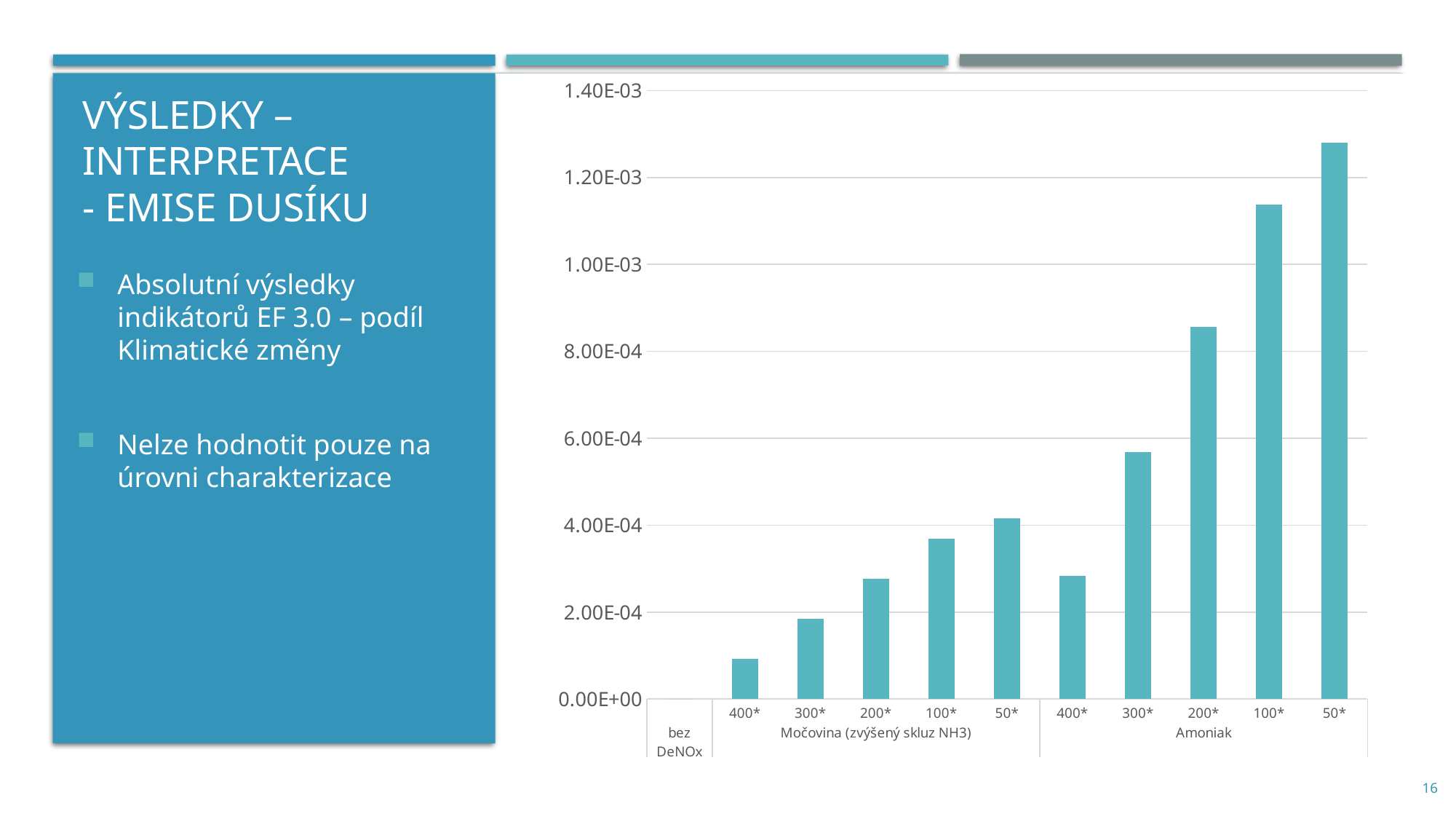
Is the value for Močovina 400* greater or less than 2.00E-04? less Which bar is the highest in the chart? Amoniak 50* Is the value for Močovina 50* greater or less than 4.00E-04? greater Which of the plotted bars is the lowest? Močovina 400* How many categories are in the Amoniak group? 5 Which is larger, the value for Amoniak 300* or the value for Močovina 50*? Amoniak 300* Is the value for Amoniak 200* greater or less than 1.00E-03? less Within the Amoniak group, do the values rise or fall from 400* to 50*? rise What kind of chart is shown on the slide? bar chart What is the highest tick label on the vertical axis? 1.40E-03 Which is larger, the value for Močovina 100* or the value for Amoniak 400*? Močovina 100*